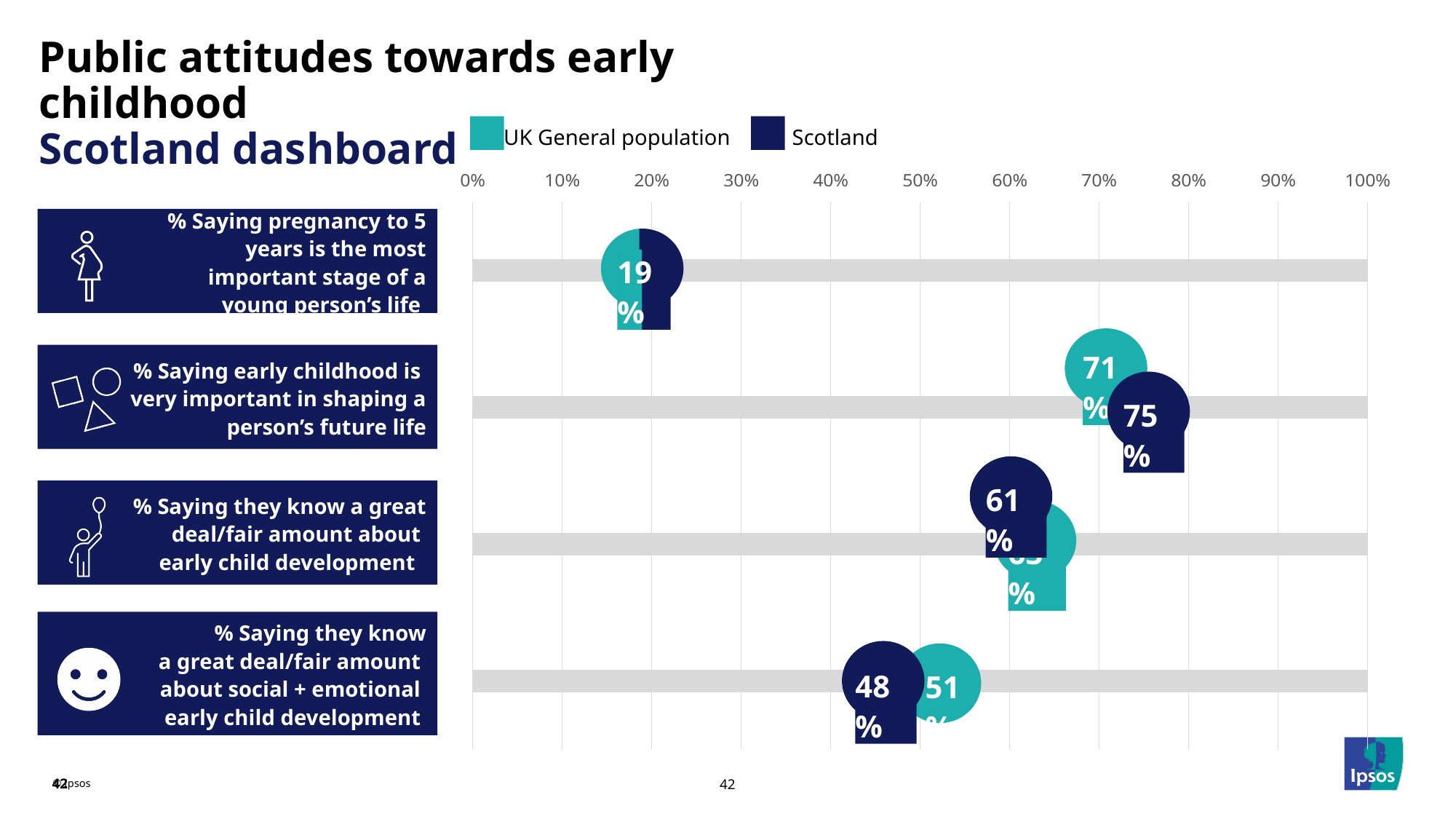
What is the UK General population value for '% Saying pregnancy to 5 years is the most important stage of a young person's life'? 19% Which statement has the highest Scotland value? % Saying early childhood is very important in shaping a person's future life By how many percentage points does Scotland exceed the UK General population for '% Saying early childhood is very important in shaping a person's future life'? 4 percentage points What is the Scotland value for '% Saying early childhood is very important in shaping a person's future life'? 75% For '% Saying they know a great deal/fair amount about social + emotional early child development', which is higher: Scotland or UK General population? UK General population What is the Scotland value for '% Saying they know a great deal/fair amount about early child development'? 61% What is the UK General population value for '% Saying early childhood is very important in shaping a person's future life'? 71% How many statements (categories) are plotted on the chart? 4 What is the Scotland value for '% Saying they know a great deal/fair amount about social + emotional early child development'? 48% How many series does the legend list? 2 Is the UK General population value for '% Saying they know a great deal/fair amount about early child development' greater or less than 60%? greater What is the UK General population value for '% Saying they know a great deal/fair amount about social + emotional early child development'? 51%